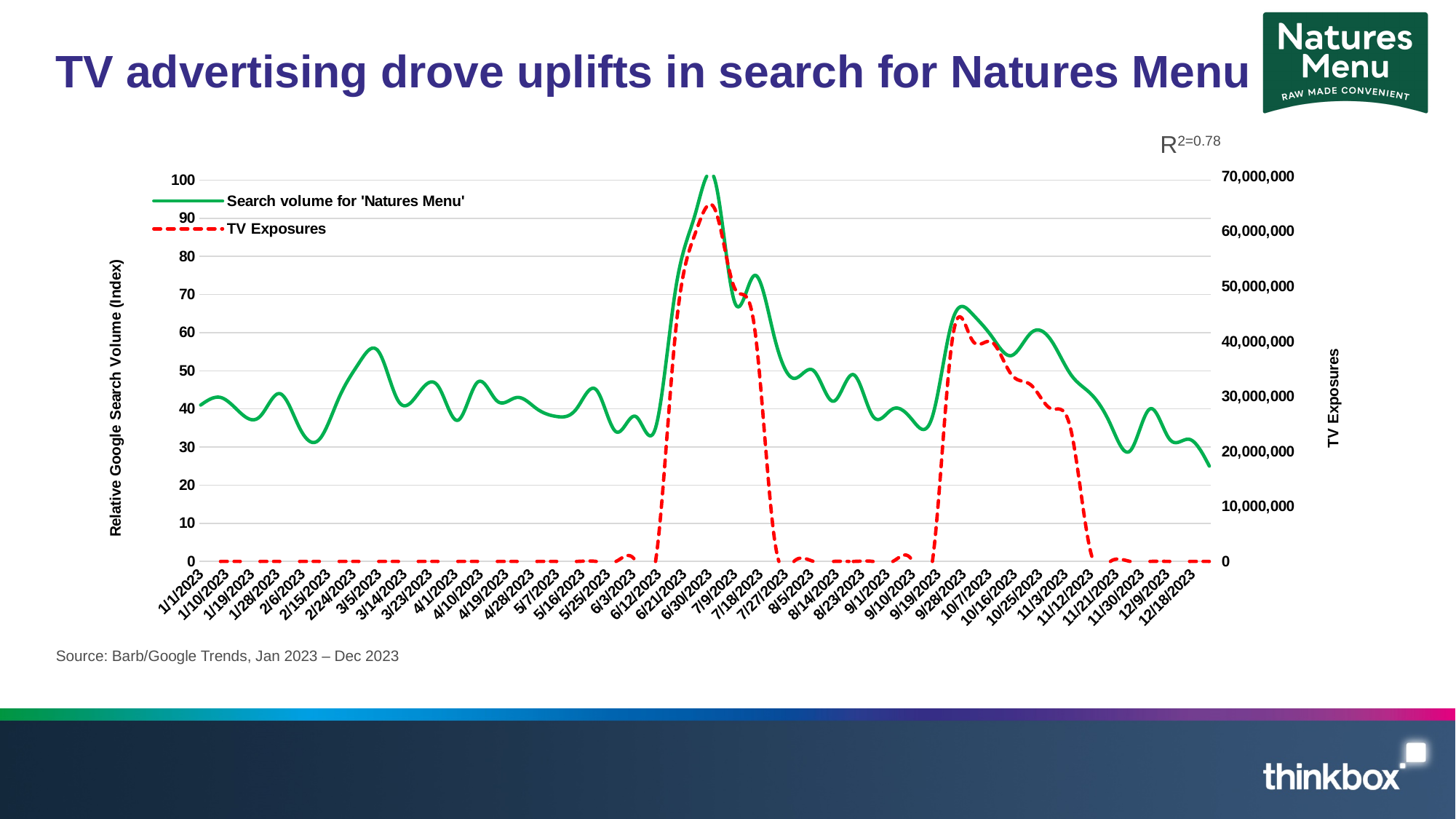
Is the search volume for 'Natures Menu' on 3/5/2023 greater or less than 50? greater How many series does the chart legend list? 2 Is the search volume for 'Natures Menu' on 6/30/2023 greater or less than 90? greater Which is larger: the search volume for 'Natures Menu' on 6/30/2023 or on 9/28/2023? 6/30/2023 What is the TV Exposures value on 3/5/2023? 0 Does the search volume for 'Natures Menu' rise or fall between 10/25/2023 and 12/18/2023? Fall Which series is drawn as a red dashed line? TV Exposures Is the TV Exposures value on 6/30/2023 greater or less than 60,000,000? greater What kind of chart is shown on the slide? Line chart What R-squared value is shown above the chart? 0.78